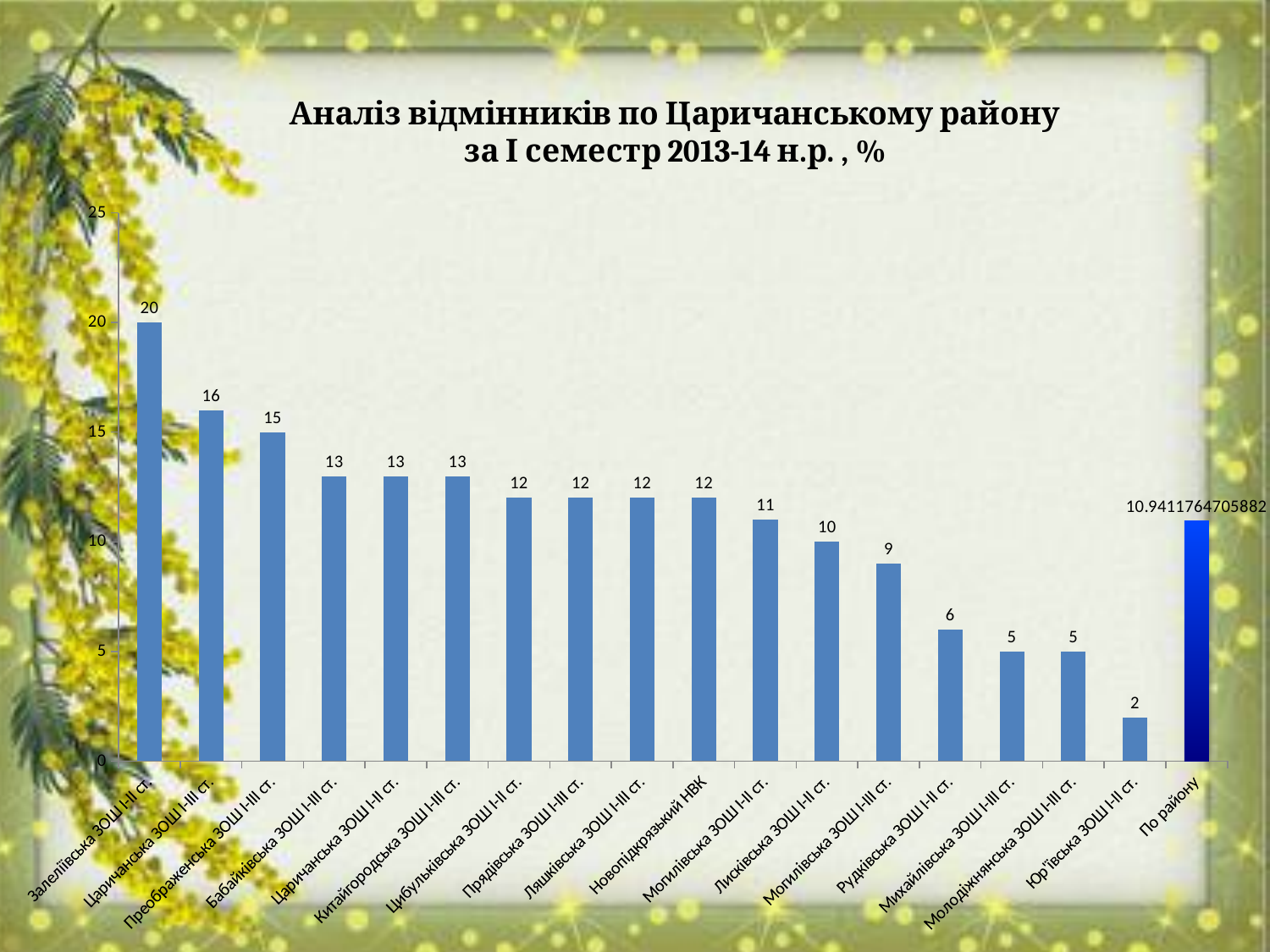
Which school has the highest value? Залелівська ЗОШ І-ІІ ст. How many bars are plotted in the chart? 18 Is the value for Лисківська ЗОШ І-ІІ ст. greater or less than 15? less What is the difference between the values for Залелівська ЗОШ І-ІІ ст. and Преображенська ЗОШ І-ІІІ ст.? 5 Which is larger, the value for Могилівська ЗОШ І-ІІ ст. or Могилівська ЗОШ І-ІІІ ст.? Могилівська ЗОШ І-ІІ ст. What is the value for Залелівська ЗОШ І-ІІ ст.? 20 What is the value for Царичанська ЗОШ І-ІІІ ст.? 16 What is the value for Рудківська ЗОШ І-ІІ ст.? 6 Which category has the lowest value? Юр'ївська ЗОШ І-ІІ ст. Do the school values rise or fall from left to right across the x axis (excluding the final По району bar)? fall What is the value shown for По району? 10.9411764705882 What kind of chart is shown on the slide? bar chart